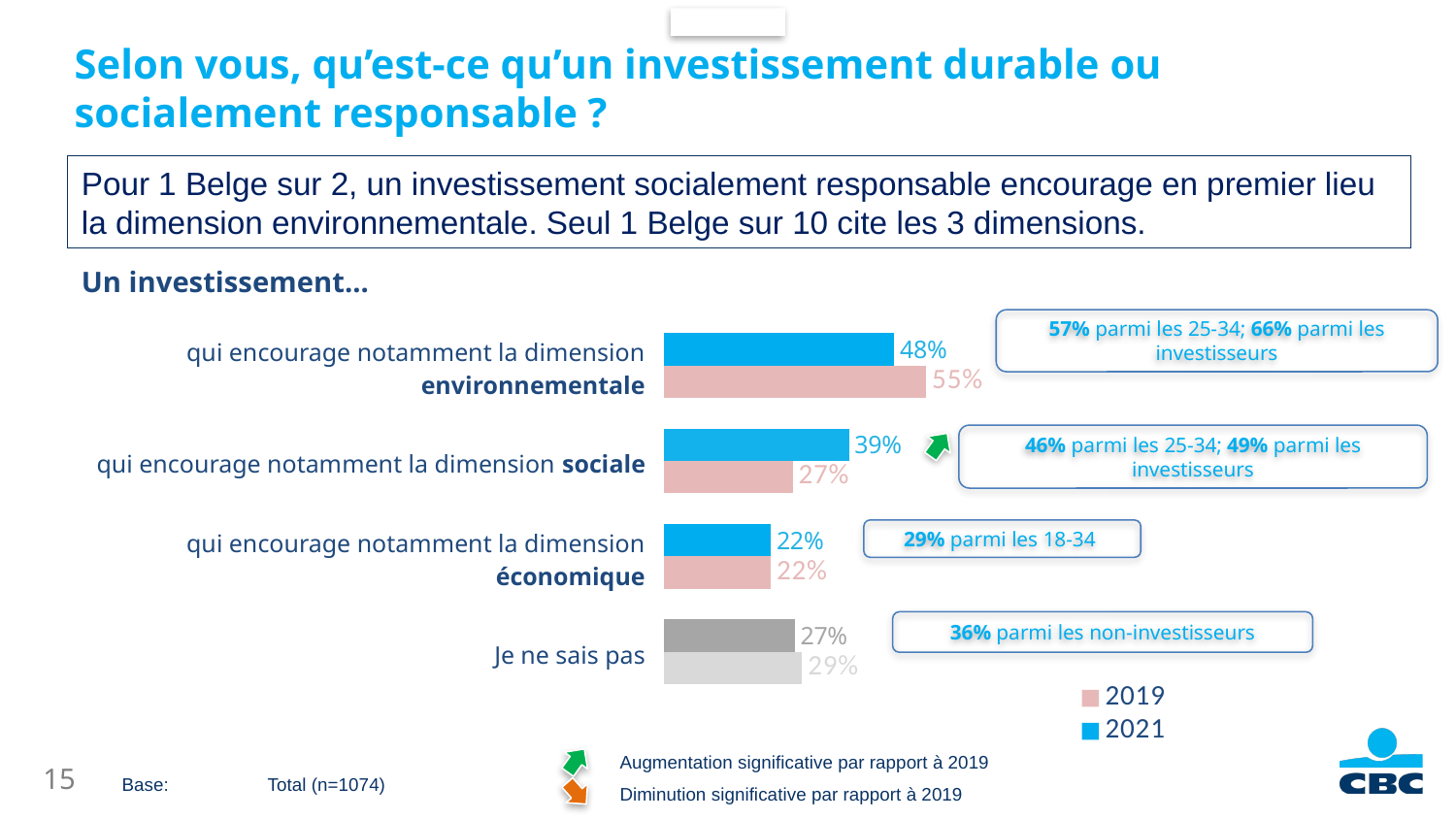
Which colour represents the 2021 series in the legend? blue What is the 2019 value for 'Je ne sais pas'? 29% What is the difference between the 2021 and 2019 values for 'qui encourage notamment la dimension sociale'? 12% For 'qui encourage notamment la dimension environnementale', which is larger: the 2019 value or the 2021 value? 2019 What is the 2019 value for 'qui encourage notamment la dimension environnementale'? 55% How many categories are plotted in the chart? 4 What is the 2021 value for 'qui encourage notamment la dimension sociale'? 39% What is the 2021 value for 'qui encourage notamment la dimension environnementale'? 48% Which category has the highest 2021 value? qui encourage notamment la dimension environnementale What type of chart is shown on the slide? bar chart How many series does the legend list? 2 Which category has the lowest 2019 value? qui encourage notamment la dimension économique